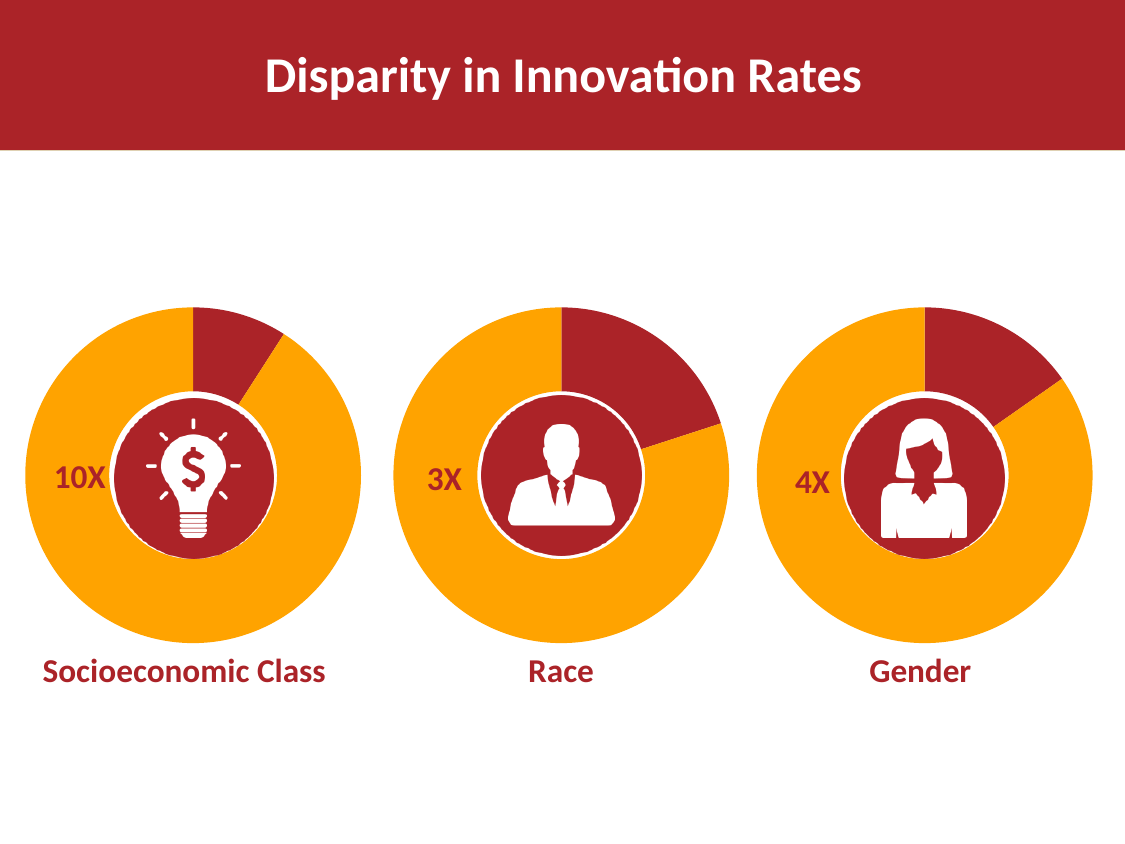
What is the value shown on the Race chart? 3X What is the difference between the Socioeconomic Class value and the Race value? 7X Which chart has the smallest dark red slice? Socioeconomic Class How many slices does each donut chart have? 2 What is the value shown on the Gender chart? 4X Which has a larger value, Gender or Race? Gender What is the value shown on the Socioeconomic Class chart? 10X What is the title of the slide? Disparity in Innovation Rates What kind of charts are shown on the slide? Pie (donut) charts Which category has the lowest disparity value? Race Which category has the highest disparity value? Socioeconomic Class How many charts are shown on the slide? 3